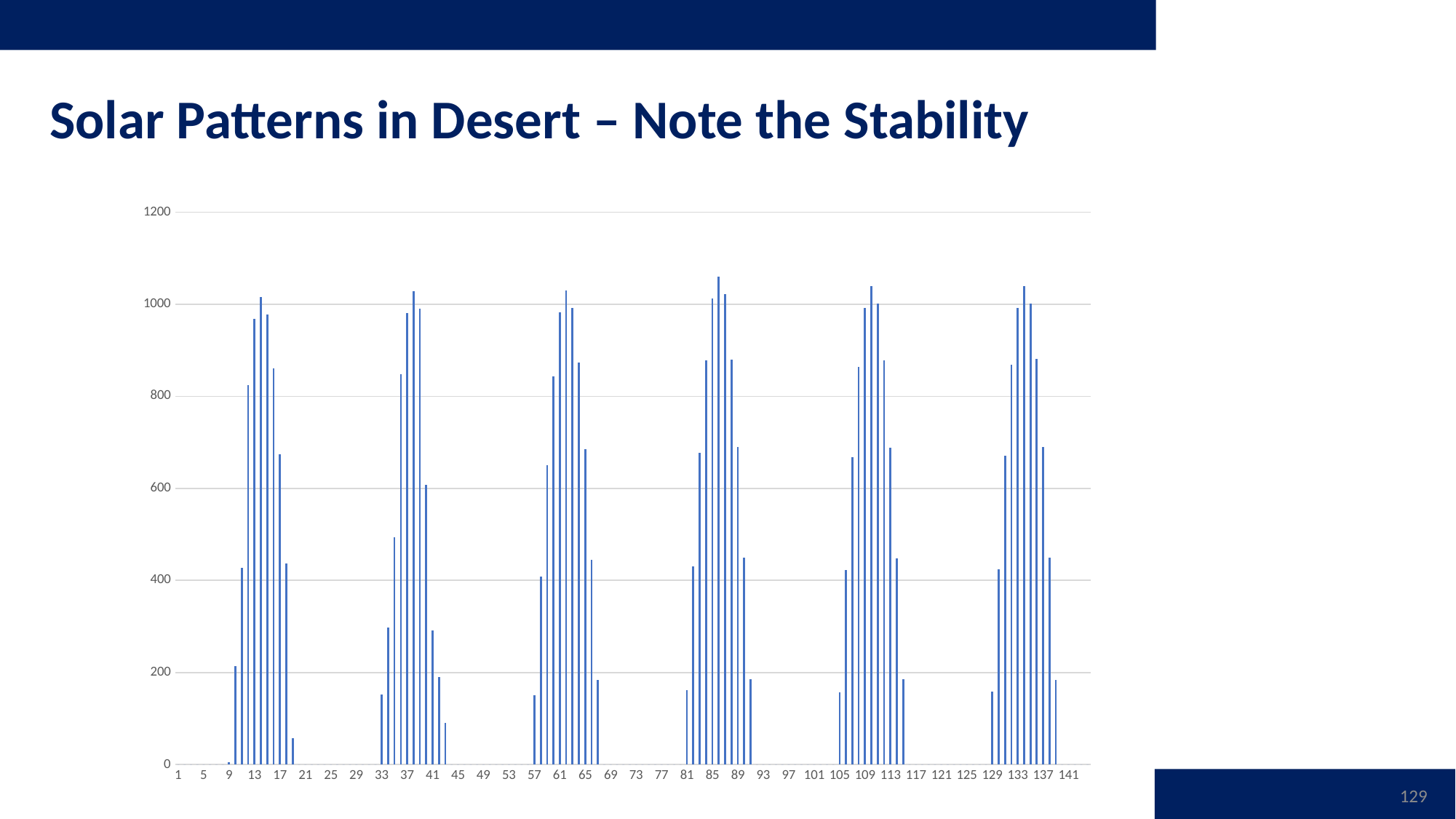
What is the highest value shown on the y axis? 1200 Is the value at x = 9 greater or less than 200? less Is the value at x = 41 greater or less than 400? less How many separate clusters of peaks appear across the x axis? 6 Which is larger, the value at x = 17 or the value at x = 21? 17 Between x = 13 and x = 21, do the values rise or fall? fall Which is larger, the value at x = 37 or the value at x = 41? 37 What kind of chart is shown on the slide? bar chart Which is larger, the value at x = 81 or the value at x = 85? 85 What is the title of the chart slide? Solar Patterns in Desert – Note the Stability Is the value at x = 17 greater or less than 600? greater